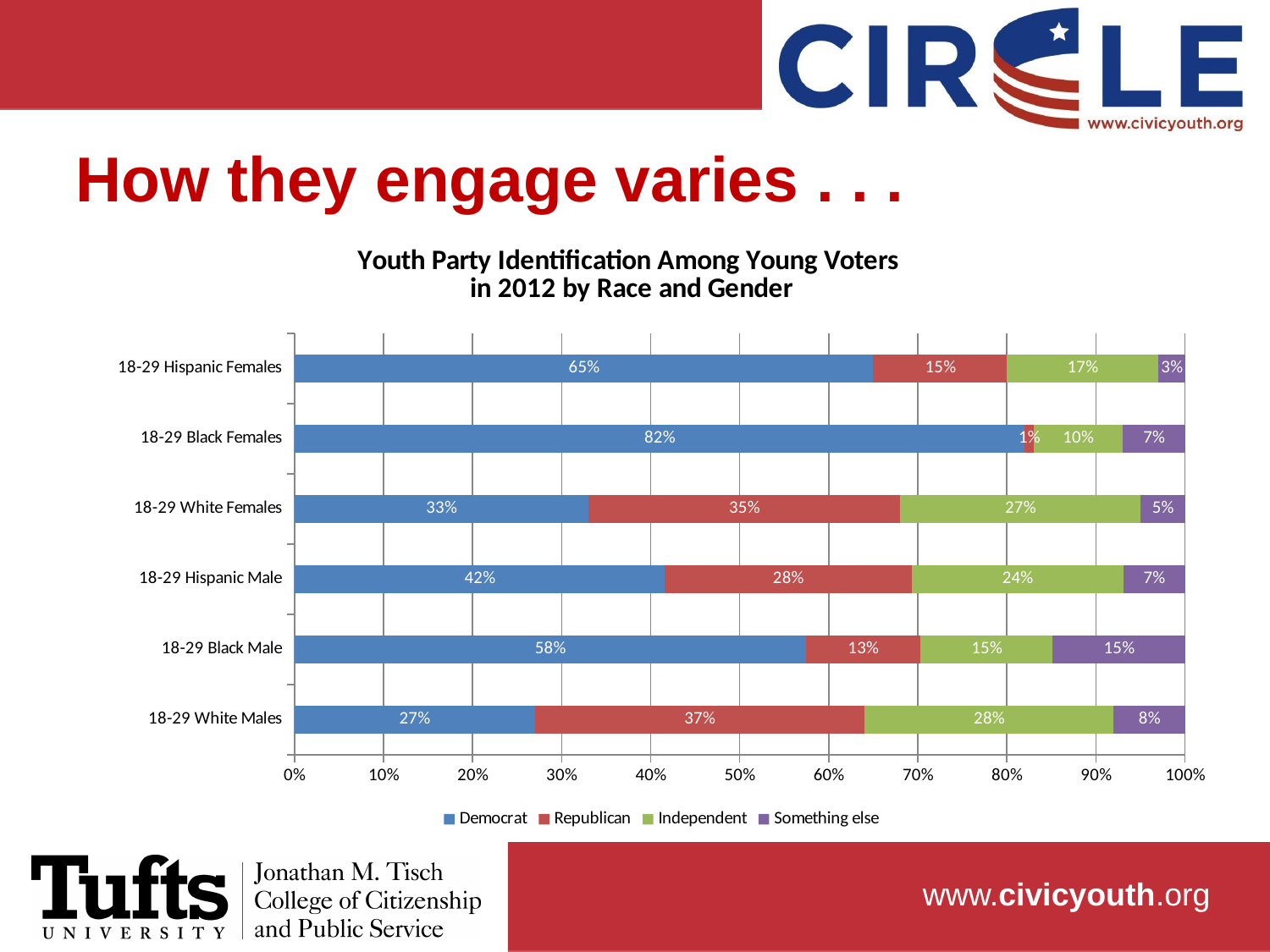
How many series does the legend list? 4 Which category has the lowest Republican value? 18-29 Black Females Which is larger: the Republican value for 18-29 White Females or the Republican value for 18-29 Hispanic Male? 18-29 White Females Which category has the highest Democrat value? 18-29 Black Females What is the Democrat value for 18-29 Black Females? 82% What is the Independent value for 18-29 Hispanic Male? 24% What is the title of the chart? Youth Party Identification Among Young Voters in 2012 by Race and Gender What is the Republican value for 18-29 White Males? 37% What is the Something else value for 18-29 Black Male? 15% What is the difference between the Democrat values for 18-29 Hispanic Females and 18-29 White Females? 32% What kind of chart is shown on the slide? Stacked bar chart How many categories are shown on the chart? 6